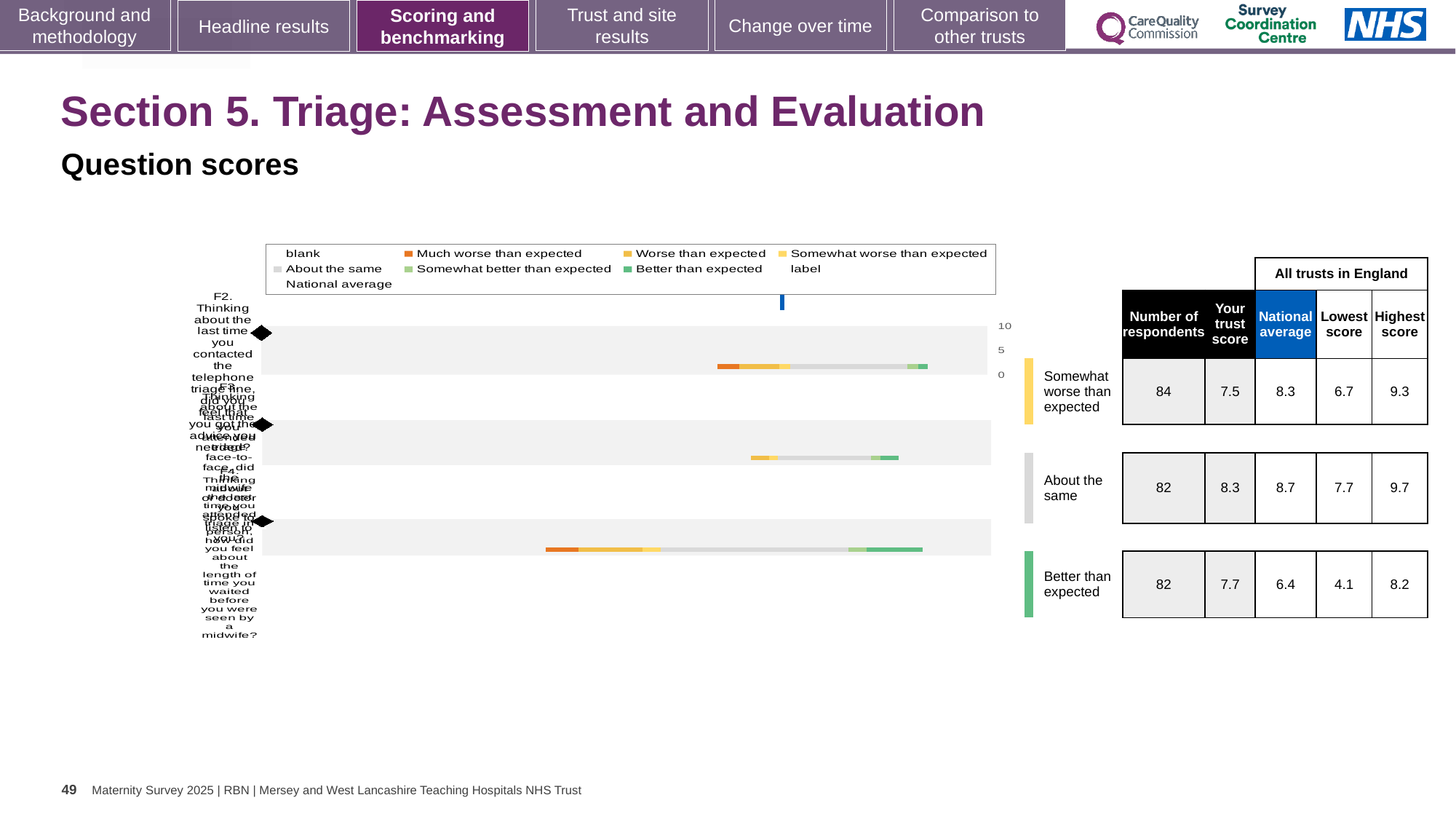
What kind of chart is shown on the slide? bar chart Which legend entry is shown in orange? Much worse than expected What is the lowest score across all trusts in England for the 'Better than expected' row? 4.1 What is the trust score for the row benchmarked as 'Better than expected'? 7.7 What is the national average for the row benchmarked as 'About the same'? 8.7 How many question bars are plotted on the chart? 3 What is the highest tick value shown on the chart's axis? 10 Which benchmark row has the highest trust score? About the same What does the blue vertical marker in the legend represent? National average What is the difference between the trust score and the national average for the 'Better than expected' row? 1.3 How many respondents are recorded for the 'Somewhat worse than expected' row? 84 For the 'Somewhat worse than expected' row, which is larger: the trust score or the national average? National average